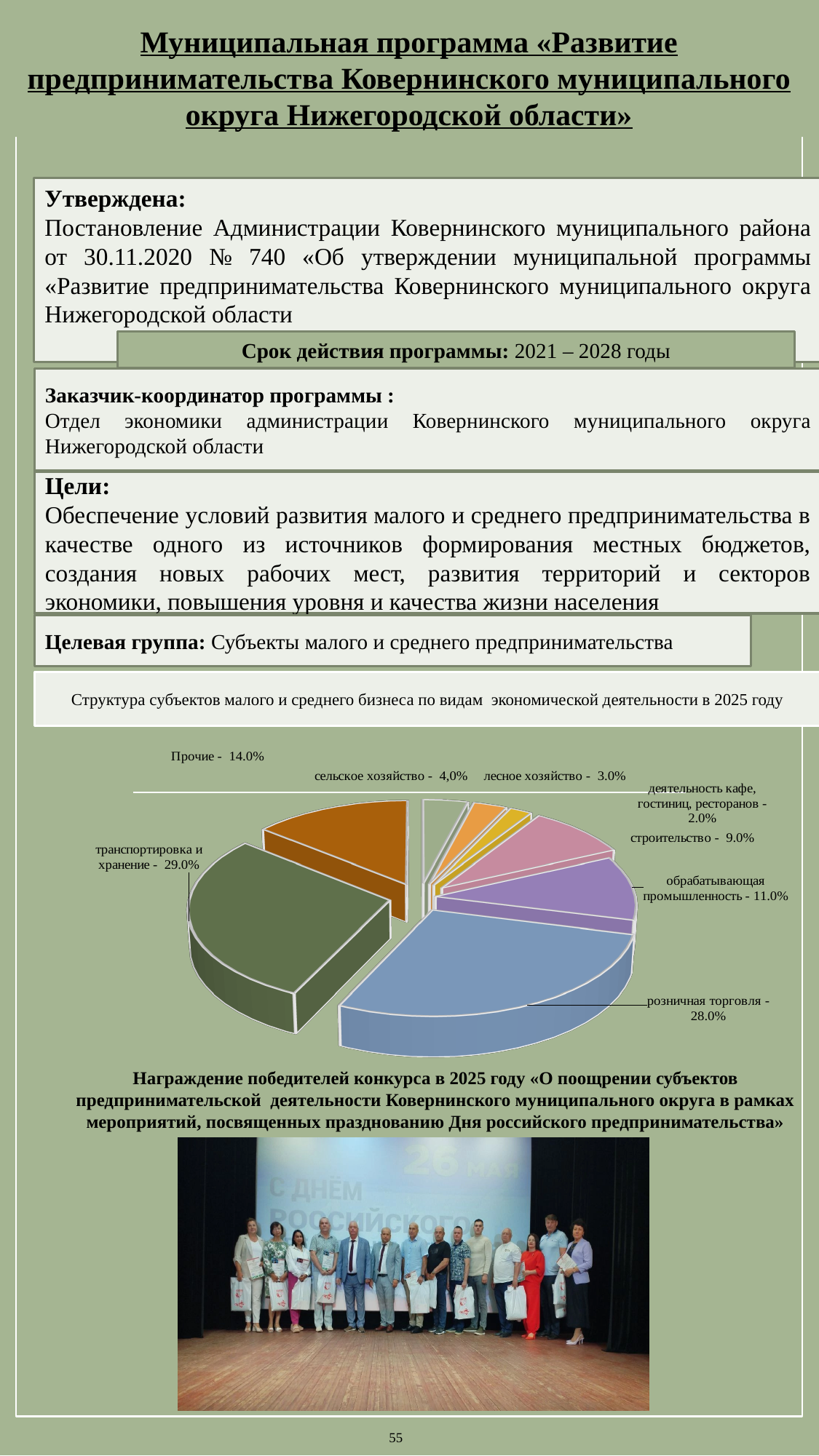
How many categories are shown in the pie chart? 8 What is the title of the pie chart? Структура субъектов малого и среднего бизнеса по видам экономической деятельности в 2025 году Which category has the smallest share in the pie chart? деятельность кафе, гостиниц, ресторанов What is the share of строительство in the pie chart? 9.0% Which category has the largest share in the pie chart? транспортировка и хранение What is the difference between the shares of Прочие and лесное хозяйство? 11.0% Which is larger: the share of строительство or the share of обрабатывающая промышленность? обрабатывающая промышленность What type of chart is shown on the slide? pie chart What is the share of сельское хозяйство in the pie chart? 4,0% What is the share of транспортировка и хранение in the pie chart? 29.0% What is the share of розничная торговля in the pie chart? 28.0% What is the share of обрабатывающая промышленность in the pie chart? 11.0%